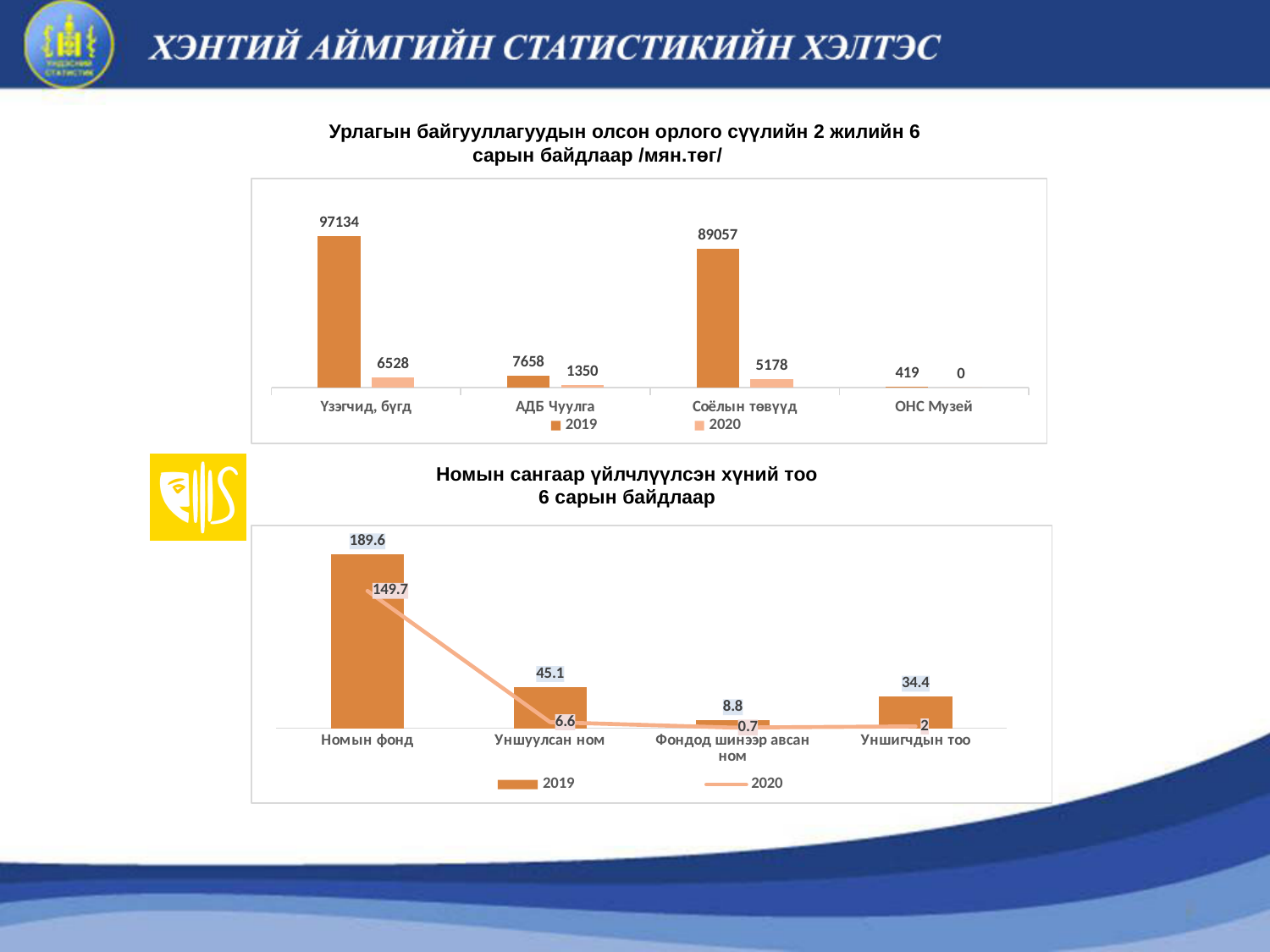
In the bottom chart (Номын сангаар үйлчлүүлсэн хүний тоо), what is the difference between the 2019 and 2020 values for Уншуулсан ном? 38.5 In the bottom chart (Номын сангаар үйлчлүүлсэн хүний тоо), what is the 2020 value for Номын фонд? 149.7 In the top chart (Урлагын байгууллагуудын олсон орлого), how many categories are shown on the x axis? 4 In the bottom chart (Номын сангаар үйлчлүүлсэн хүний тоо), what is the 2019 value for Уншигчдын тоо? 34.4 In the top chart (Урлагын байгууллагуудын олсон орлого), which is larger: the 2020 value for Үзэгчид, бүгд or the 2020 value for Соёлын төвүүд? Үзэгчид, бүгд What kind of chart is the top chart (Урлагын байгууллагуудын олсон орлого)? Bar chart In the top chart (Урлагын байгууллагуудын олсон орлого), what is the 2020 value for Соёлын төвүүд? 5178 In the top chart (Урлагын байгууллагуудын олсон орлого), which category has the lowest 2019 value? ОНС Музей In the top chart (Урлагын байгууллагуудын олсон орлого), what is the difference between the 2019 and 2020 values for АДБ Чуулга? 6308 In the bottom chart (Номын сангаар үйлчлүүлсэн хүний тоо), which category has the highest 2019 value? Номын фонд In the bottom chart (Номын сангаар үйлчлүүлсэн хүний тоо), how many series does the legend list? 2 In the top chart (Урлагын байгууллагуудын олсон орлого), what is the 2019 value for Үзэгчид, бүгд? 97134